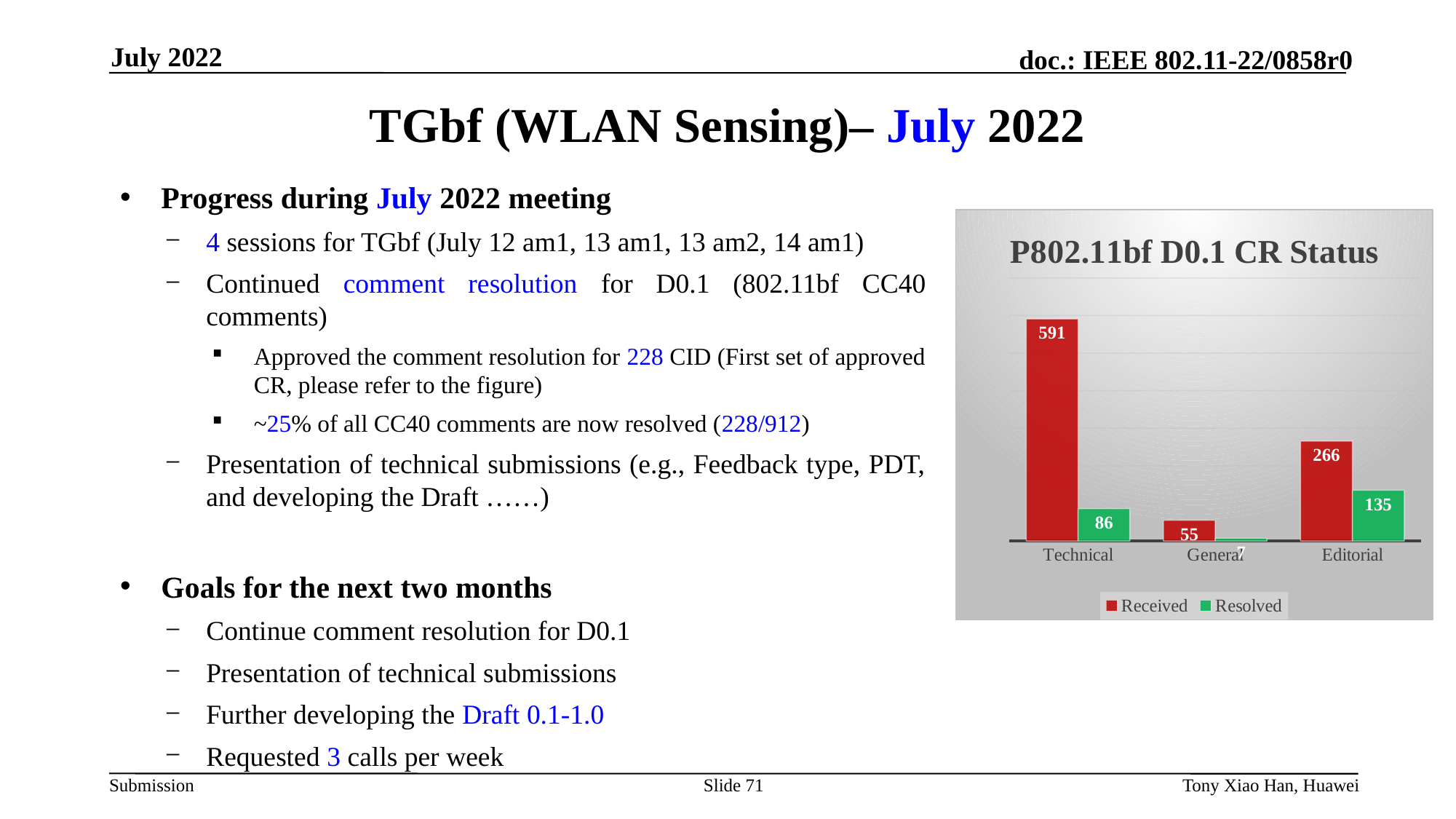
What is the Received value for Editorial? 266 Which category has the lowest Received value? General Which category has the highest Received value? Technical What is the difference between the Received and Resolved values for Editorial? 131 What type of chart is shown on the slide? bar chart How many categories are shown on the x axis of the chart? 3 What is the Resolved value for Editorial? 135 What is the title of the chart? P802.11bf D0.1 CR Status What is the Received value for Technical? 591 How many series does the chart legend list? 2 What is the Resolved value for Technical? 86 What is the Received value for General? 55